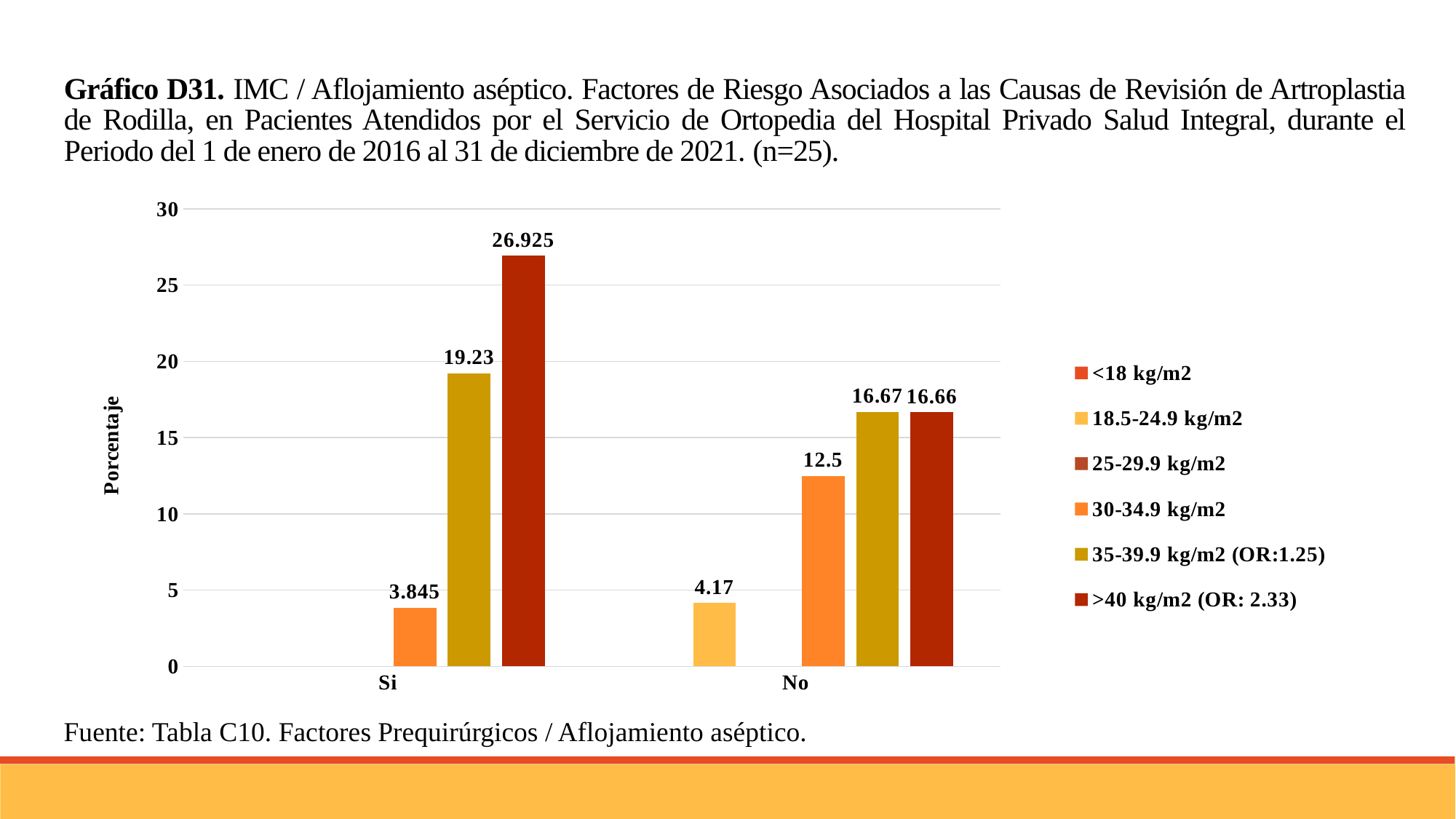
What is the label of the vertical axis? Porcentaje Is the value for 35-39.9 kg/m2 (OR:1.25) in the Si category greater or less than 15? greater Which series has the lowest value in the No category? 18.5-24.9 kg/m2 Which is larger: the 30-34.9 kg/m2 value in the Si category or in the No category? No What is the value for the 30-34.9 kg/m2 series in the Si category? 3.845 Which series has the highest value in the Si category? >40 kg/m2 (OR: 2.33) What is the value for the 35-39.9 kg/m2 (OR:1.25) series in the No category? 16.67 How many series does the legend list? 6 What is the difference between the >40 kg/m2 (OR: 2.33) value and the 35-39.9 kg/m2 (OR:1.25) value in the Si category? 7.695 What kind of chart is shown on the slide? bar chart What is the value for the >40 kg/m2 (OR: 2.33) series in the Si category? 26.925 What is the value for the 18.5-24.9 kg/m2 series in the No category? 4.17